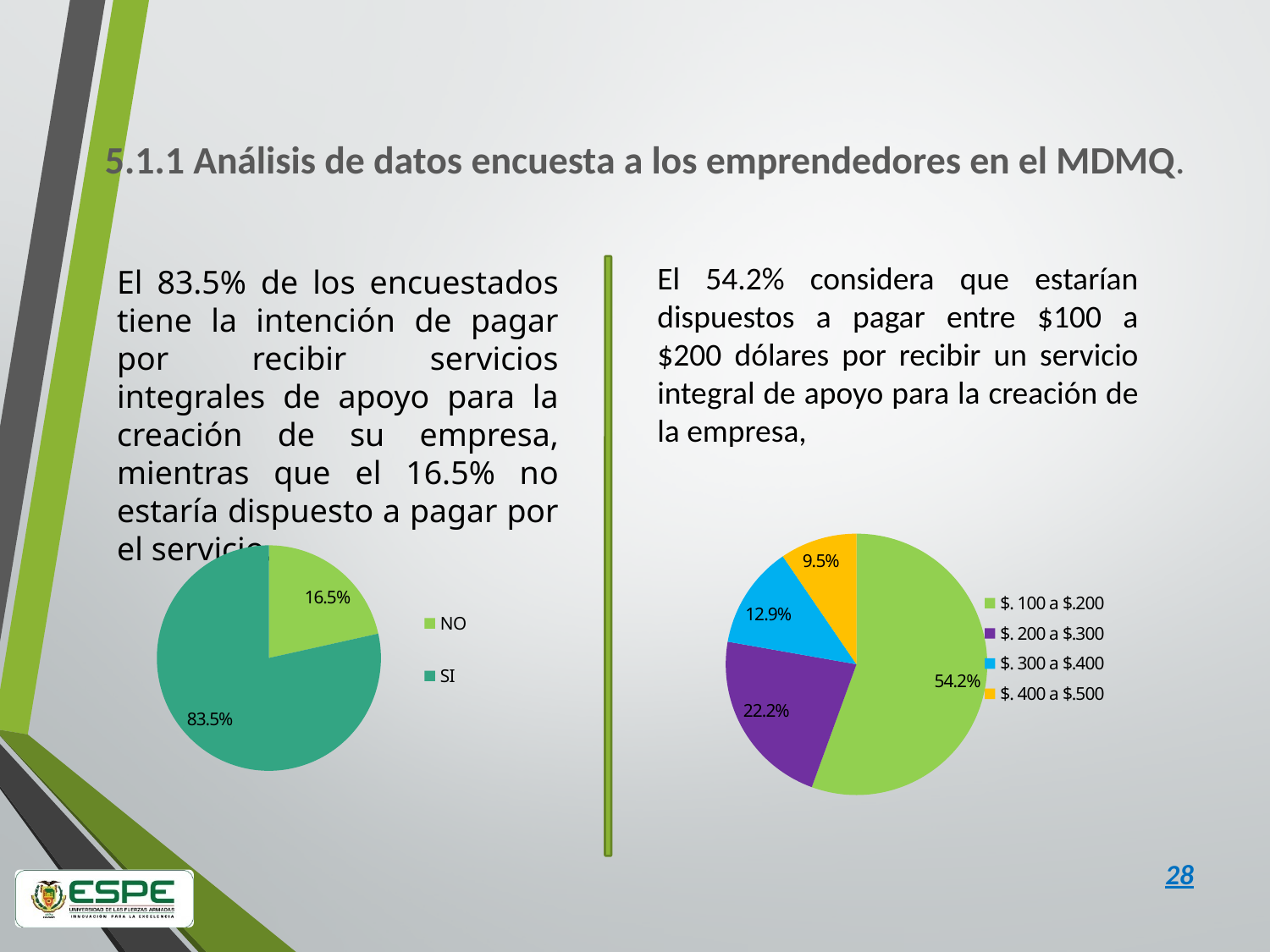
In the pie chart on the right, which category has the smallest slice? $. 400 a $.500 In the pie chart on the left, which category has the largest slice? SI In the pie chart on the right, which is larger: $. 200 a $.300 or $. 300 a $.400? $. 200 a $.300 In the pie chart on the left, what is the difference between the SI and NO slices? 67.0% In the pie chart on the right, what is the value for $. 200 a $.300? 22.2% In the pie chart on the right, how many categories are shown? 4 In the pie chart on the left, how many entries does the legend list? 2 In the pie chart on the right, what is the value for $. 300 a $.400? 12.9% In the pie chart on the right, what is the value for $. 100 a $.200? 54.2% In the pie chart on the left, what is the value for NO? 16.5% In the pie chart on the left, what is the value for SI? 83.5% What type of chart is shown on the right side of the slide? Pie chart